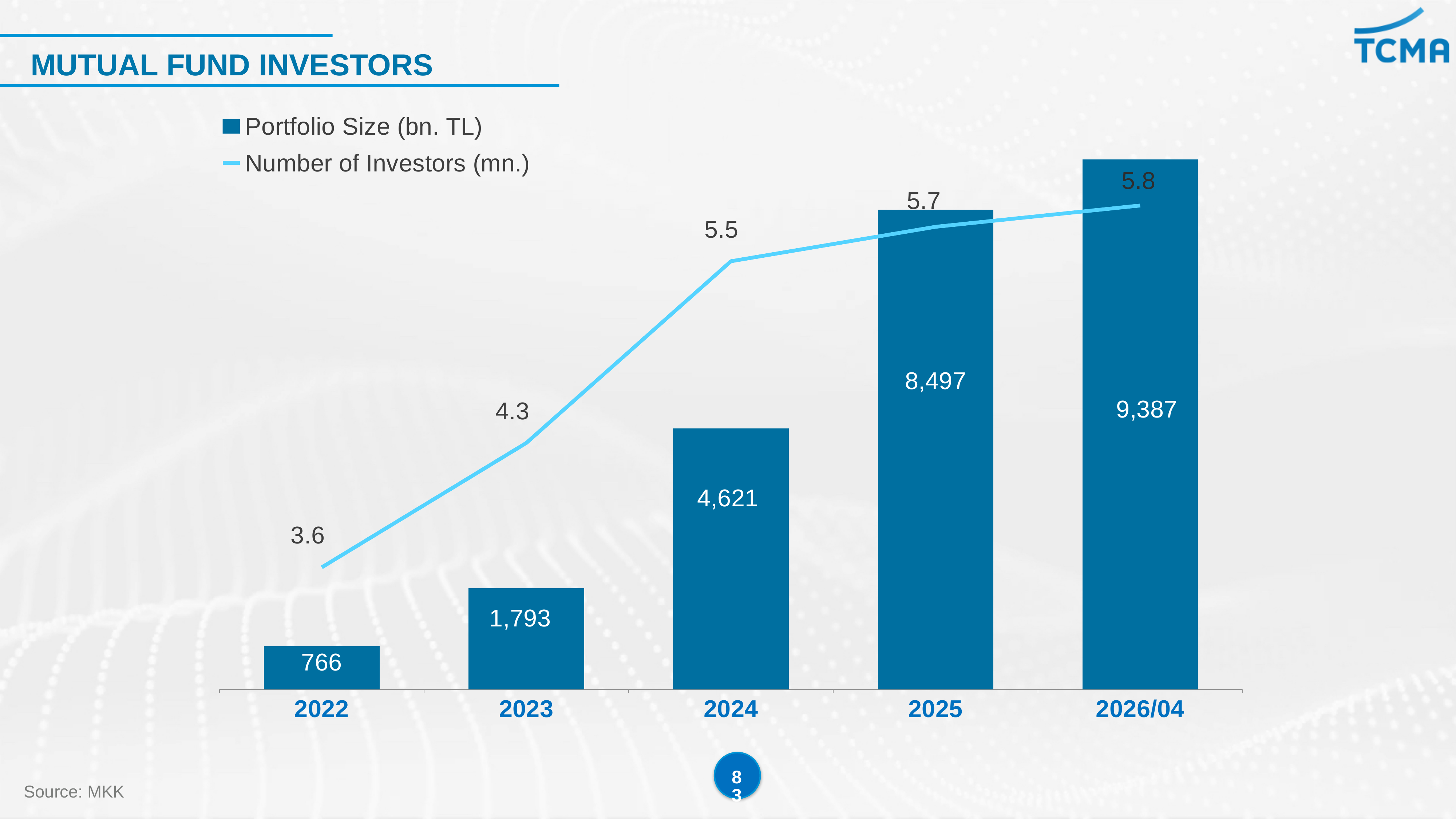
Which is larger, the Portfolio Size (bn. TL) for 2023 or for 2024? 2024 What is the Portfolio Size (bn. TL) for 2024? 4,621 Which category has the highest Number of Investors (mn.)? 2026/04 Does the Number of Investors (mn.) rise or fall from 2022 to 2026/04? rise What is the difference in Portfolio Size (bn. TL) between 2025 and 2024? 3,876 How many series does the legend list? 2 What is the Portfolio Size (bn. TL) for 2026/04? 9,387 How many categories are shown on the x axis? 5 What is the difference in Number of Investors (mn.) between 2024 and 2022? 1.9 Which year has the lowest Portfolio Size (bn. TL)? 2022 What is the Number of Investors (mn.) for 2023? 4.3 What is the title of the slide? MUTUAL FUND INVESTORS